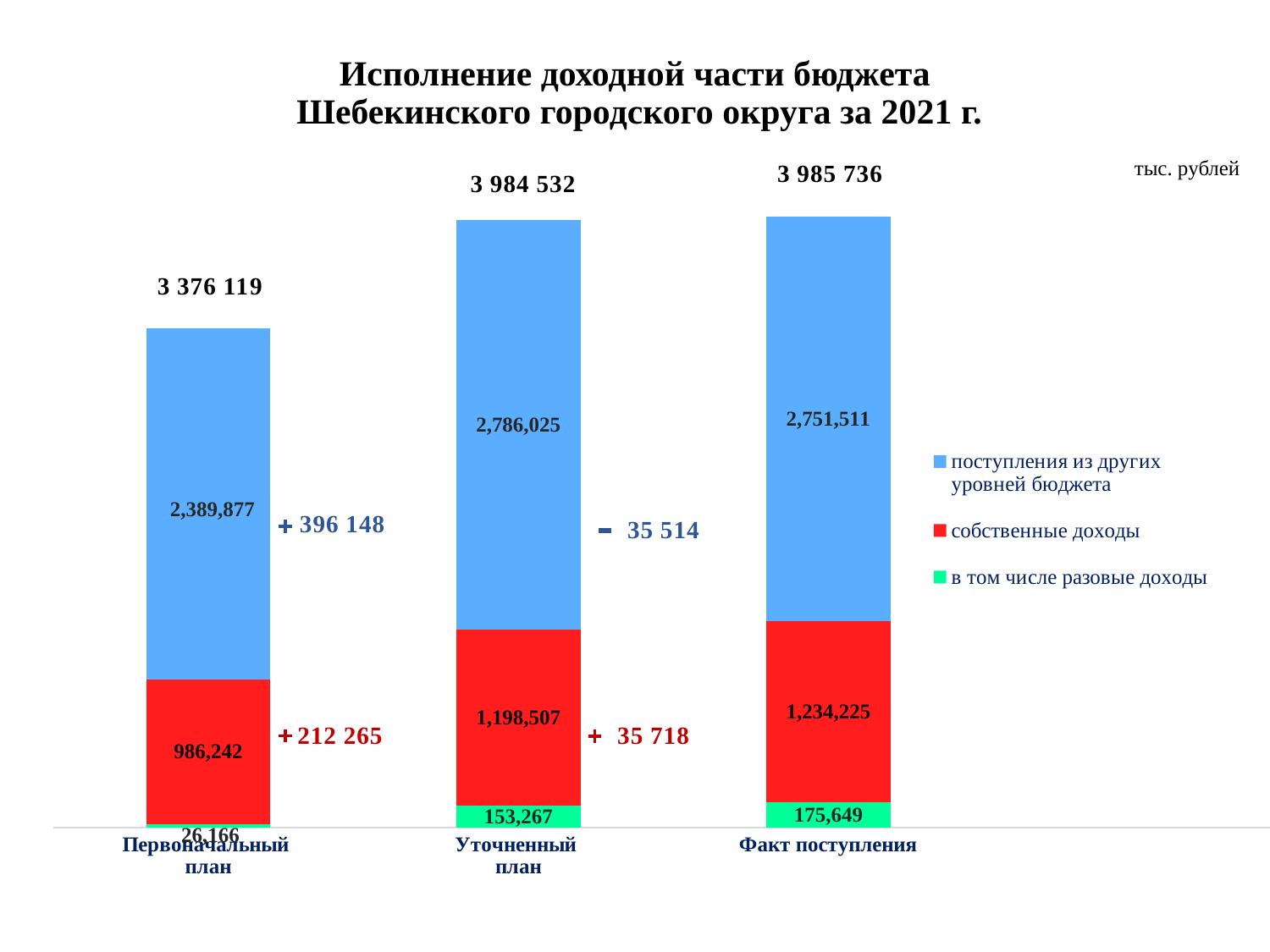
What is the difference in 'собственные доходы' between 'Уточненный план' and 'Первоначальный план'? 212,265 How many categories are shown on the x axis? 3 Which category has the lowest total printed above its bar? Первоначальный план What total is printed above the 'Факт поступления' bar? 3 985 736 How many series does the legend list? 3 What type of chart is shown on the slide? Stacked bar chart Which is larger: 'собственные доходы' for 'Факт поступления' or for 'Уточненный план'? Факт поступления What is the value of 'поступления из других уровней бюджета' for 'Уточненный план'? 2,786,025 What unit of measurement is indicated in the top right of the chart? тыс. рублей Which category has the highest value for 'поступления из других уровней бюджета'? Уточненный план What is the value of 'собственные доходы' for 'Факт поступления'? 1,234,225 What is the value of 'в том числе разовые доходы' for 'Первоначальный план'? 26,166